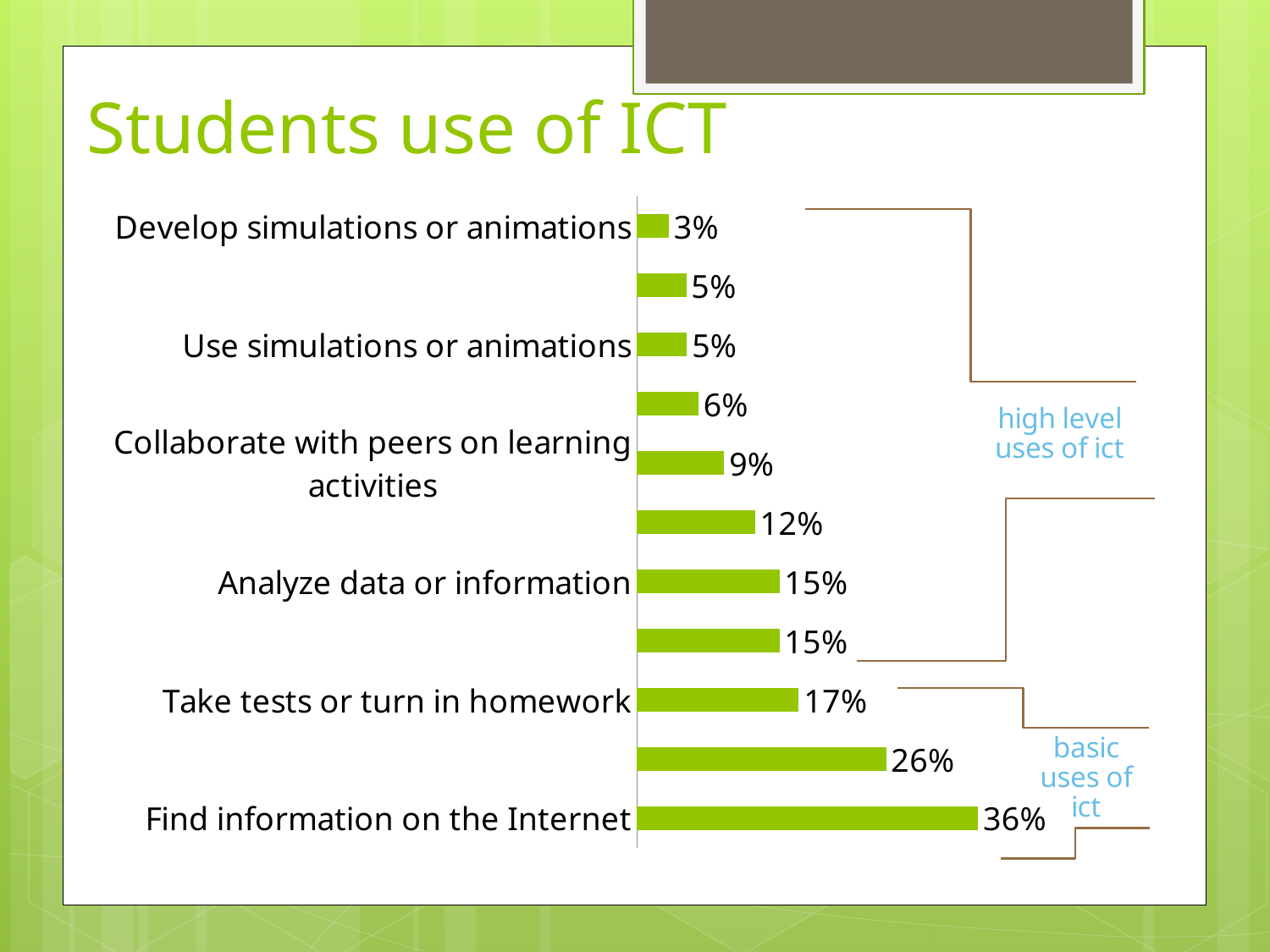
How many bars are plotted in the chart? 11 What is the value for Collaborate with peers on learning activities? 9% What is the difference between Find information on the Internet and Take tests or turn in homework? 19% What is the value for Take tests or turn in homework? 17% What is the value for Analyze data or information? 15% What is the value for Develop simulations or animations? 3% What is the value for Find information on the Internet? 36% Which group of bars is labelled 'basic uses of ict' by the bracket on the right? The bottom three bars (17%, 26%, 36%) Which category has the highest value? Find information on the Internet Which is larger, Analyze data or information or Use simulations or animations? Analyze data or information What kind of chart is shown on the slide? Bar chart Which category has the lowest value? Develop simulations or animations